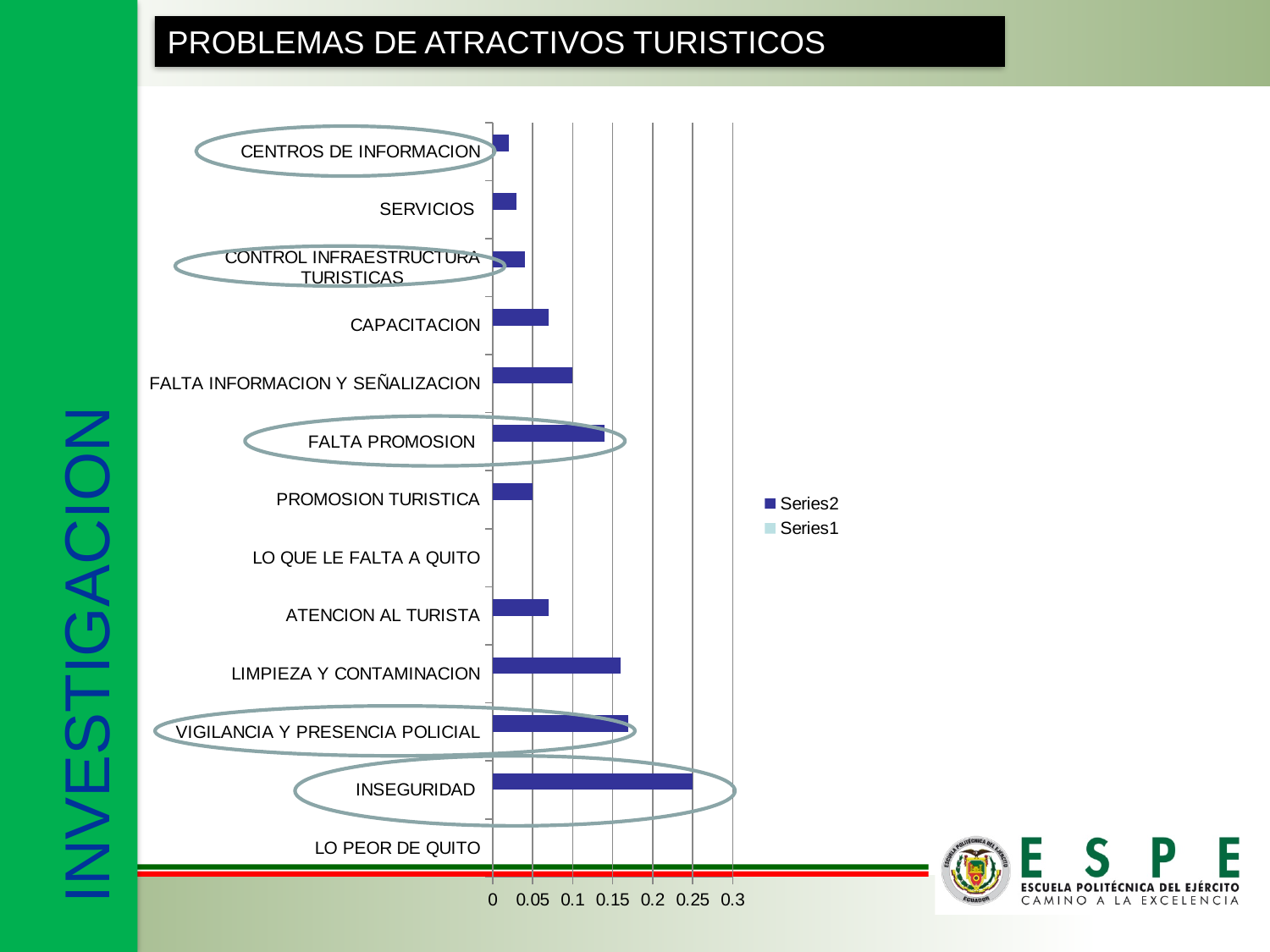
Is the value for VIGILANCIA Y PRESENCIA POLICIAL greater or less than 0.15? greater What kind of chart is shown on the slide? Bar chart Is the value for SERVICIOS greater or less than 0.05? less What is the title of the chart? PROBLEMAS DE ATRACTIVOS TURISTICOS Is the value for INSEGURIDAD greater or less than 0.2? greater Which is larger, the value for LIMPIEZA Y CONTAMINACION or the value for CAPACITACION? LIMPIEZA Y CONTAMINACION Which is larger, the value for FALTA PROMOSION or the value for PROMOSION TURISTICA? FALTA PROMOSION Which is larger, the value for INSEGURIDAD or the value for VIGILANCIA Y PRESENCIA POLICIAL? INSEGURIDAD How many series does the legend list? 2 Which category has the longest bar? INSEGURIDAD How many categories are listed on the vertical axis of the chart? 13